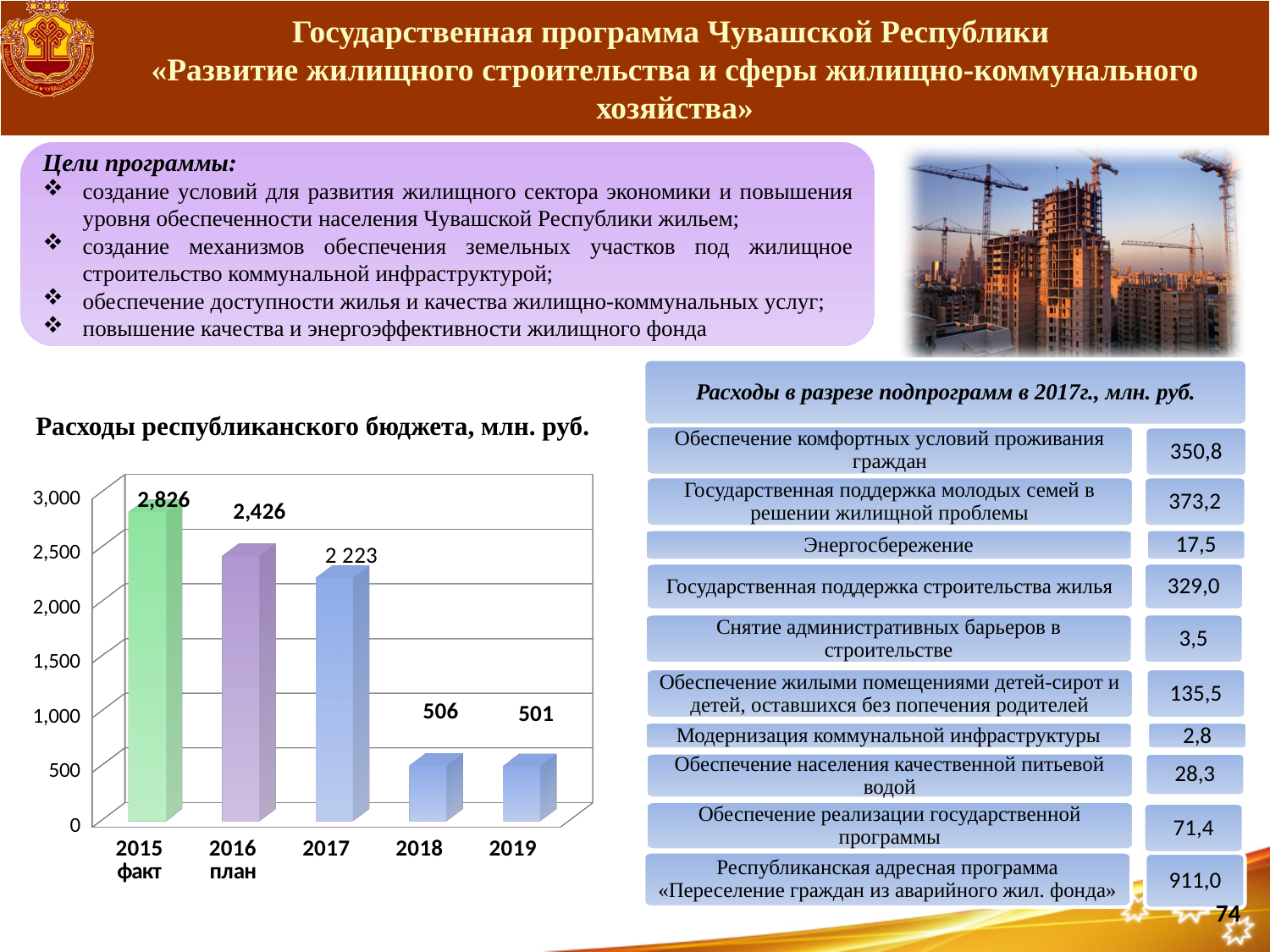
How many bars are plotted in the chart "Расходы республиканского бюджета, млн. руб."? 5 Which year has the highest value in the chart "Расходы республиканского бюджета, млн. руб."? 2015 факт In the chart "Расходы республиканского бюджета, млн. руб.", which is larger: the value for 2016 план or the value for 2017? 2016 план What is the value for 2017 in the chart "Расходы республиканского бюджета, млн. руб."? 2 223 What is the value for 2015 факт in the chart "Расходы республиканского бюджета, млн. руб."? 2,826 What is the value for 2019 in the chart "Расходы республиканского бюджета, млн. руб."? 501 What is the value for 2018 in the chart "Расходы республиканского бюджета, млн. руб."? 506 In the chart "Расходы республиканского бюджета, млн. руб.", what is the difference between the values for 2015 факт and 2016 план? 400 Do the values in the chart "Расходы республиканского бюджета, млн. руб." rise or fall from 2015 to 2019? fall What is the value for 2016 план in the chart "Расходы республиканского бюджета, млн. руб."? 2,426 Which year has the lowest value in the chart "Расходы республиканского бюджета, млн. руб."? 2019 What type of chart is shown under the title "Расходы республиканского бюджета, млн. руб."? bar chart